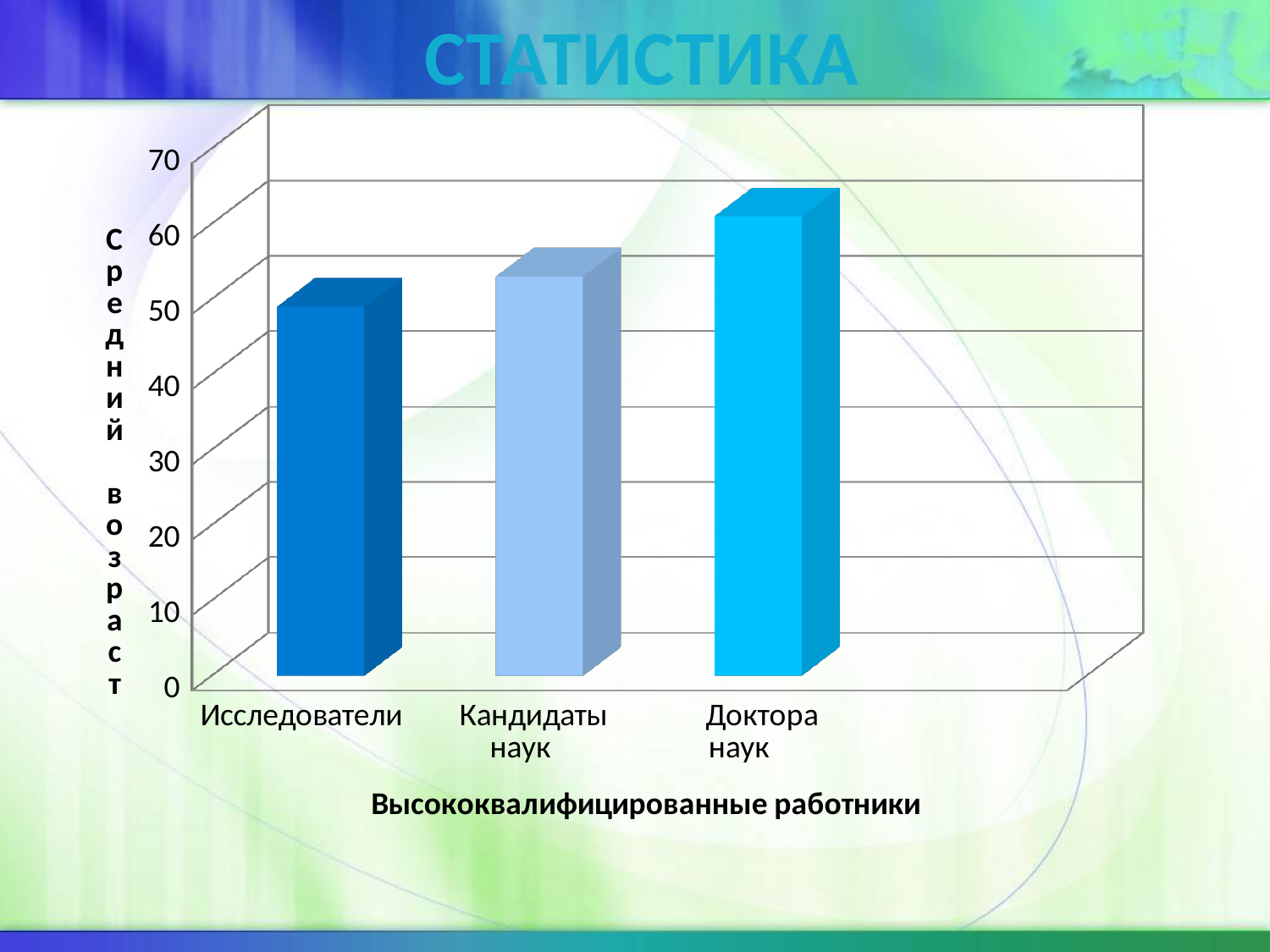
Do the bar values rise or fall from left to right across the categories? rise Is the value for Исследователи greater or less than 60? less Is the value for Доктора наук greater or less than 50? greater Which is larger, the value for Кандидаты наук or the value for Исследователи? Кандидаты наук What is the title of the horizontal axis of the chart? Высококвалифицированные работники Is the value for Кандидаты наук greater or less than 40? greater Which category has the highest bar in the chart? Доктора наук How many categories are shown on the x axis of the chart? 3 Which category has the lowest bar in the chart? Исследователи What is the title of the vertical axis of the chart? Средний возраст What kind of chart is shown on the slide? bar chart Which is larger, the value for Доктора наук or the value for Исследователи? Доктора наук